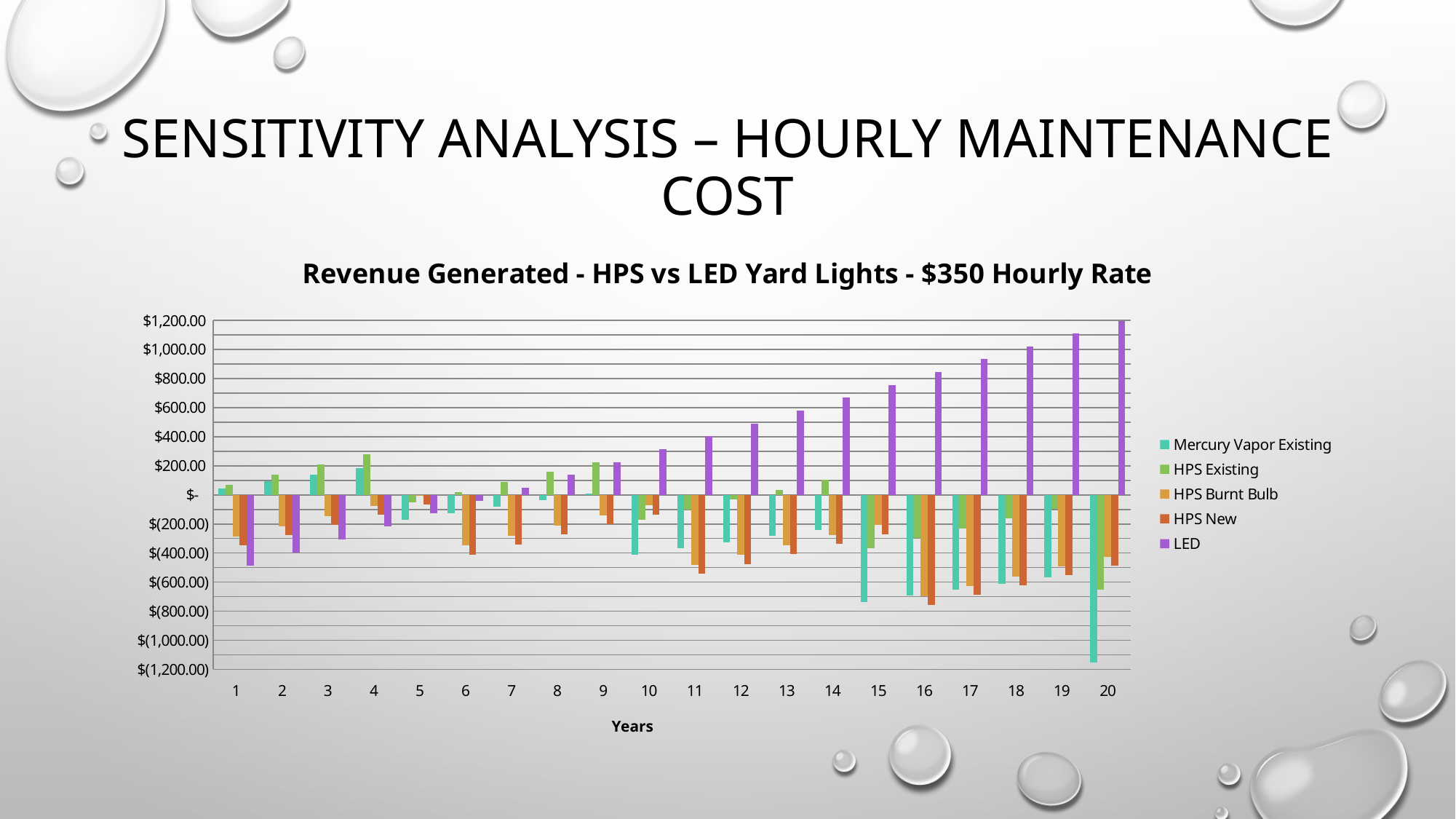
What is the title of the chart? Revenue Generated - HPS vs LED Yard Lights - $350 Hourly Rate Which series has the lowest value in year 20? Mercury Vapor Existing In year 15, which is larger: the LED value or the Mercury Vapor Existing value? LED How many series does the legend list? 5 How many years are shown along the x axis? 20 What is the label of the x axis? Years Is the LED value in year 20 greater or less than $1,000.00? greater What kind of chart is shown on the slide? bar chart Which series has the highest value in year 20? LED Is the LED value in year 1 greater or less than $(400.00)? less Is the Mercury Vapor Existing value in year 20 greater or less than $(1,000.00)? less Does the LED series rise or fall from year 5 to year 20? rise